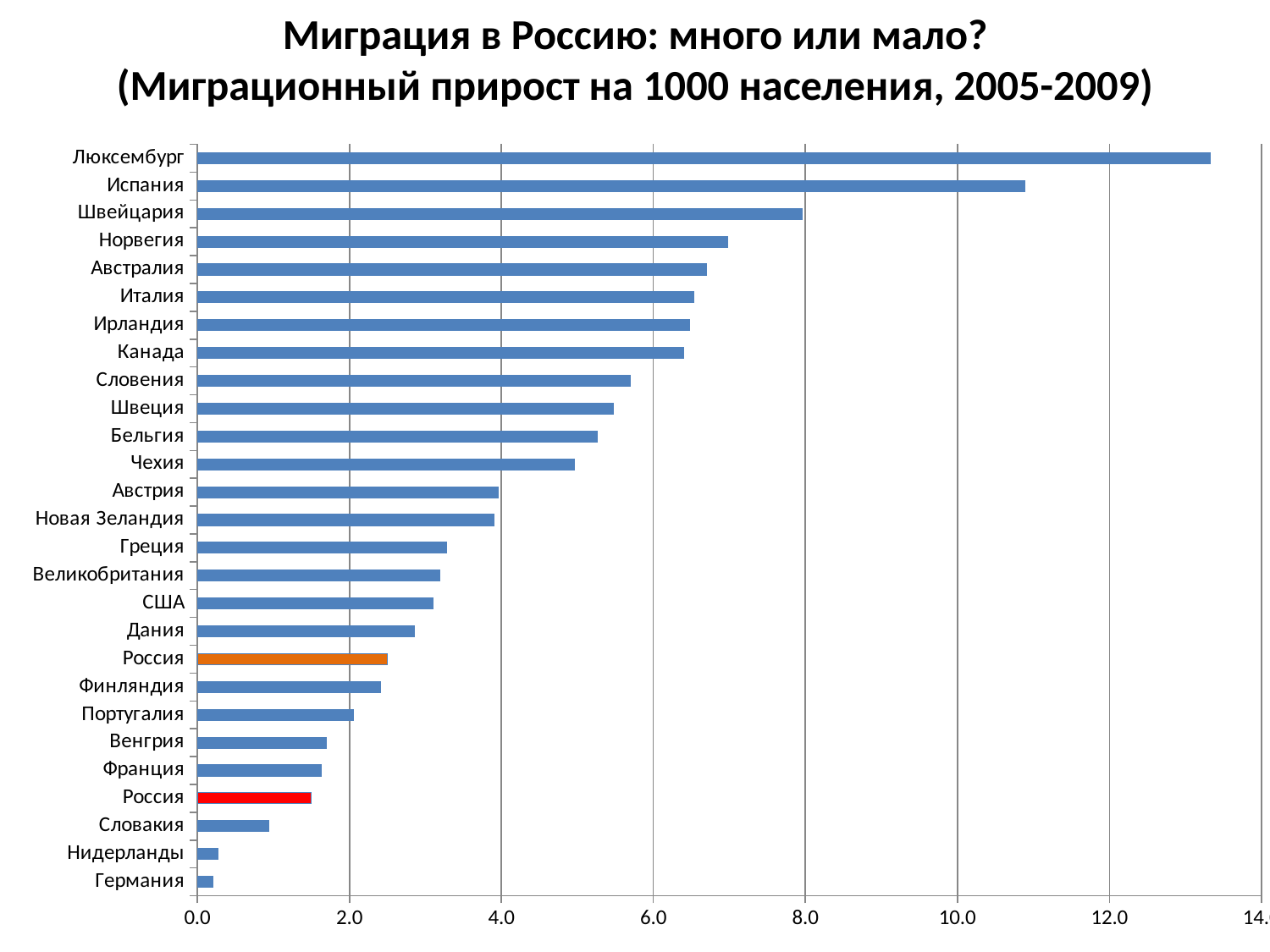
Do the bar values increase or decrease going from the top of the chart to the bottom? decrease Which has a larger value, Канада or Чехия? Канада How many bars (categories) are plotted in the chart? 27 What kind of chart is shown on the slide? bar chart What colour is the lower of the two bars labelled Россия? red Which has a larger value, Испания or Швейцария? Испания Which country has the highest migration gain per 1000 population in the chart? Люксембург Is the value for Испания greater or less than 10.0? greater Is the value for Австралия greater or less than 6.0? greater Is the value for Дания greater or less than 2.0? greater